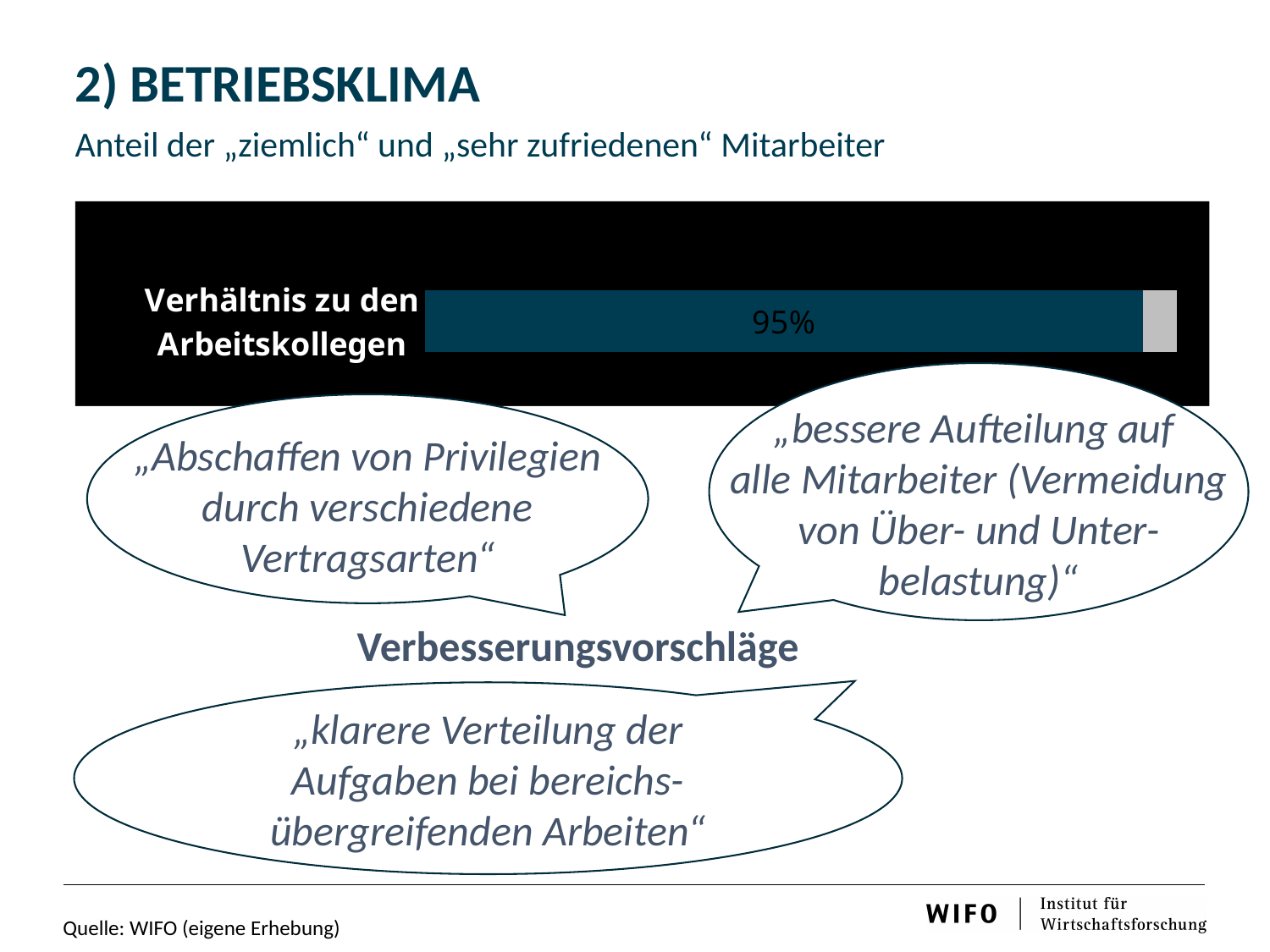
What is the value shown for "Verhältnis zu den Arbeitskollegen"? 95% Which category is plotted in the chart? Verhältnis zu den Arbeitskollegen Is the bar for "Verhältnis zu den Arbeitskollegen" oriented horizontally or vertically? horizontally How many categories does the chart show? 1 According to the subtitle, what share does the chart show? Anteil der „ziemlich“ und „sehr zufriedenen“ Mitarbeiter What kind of chart is shown on the slide? bar chart